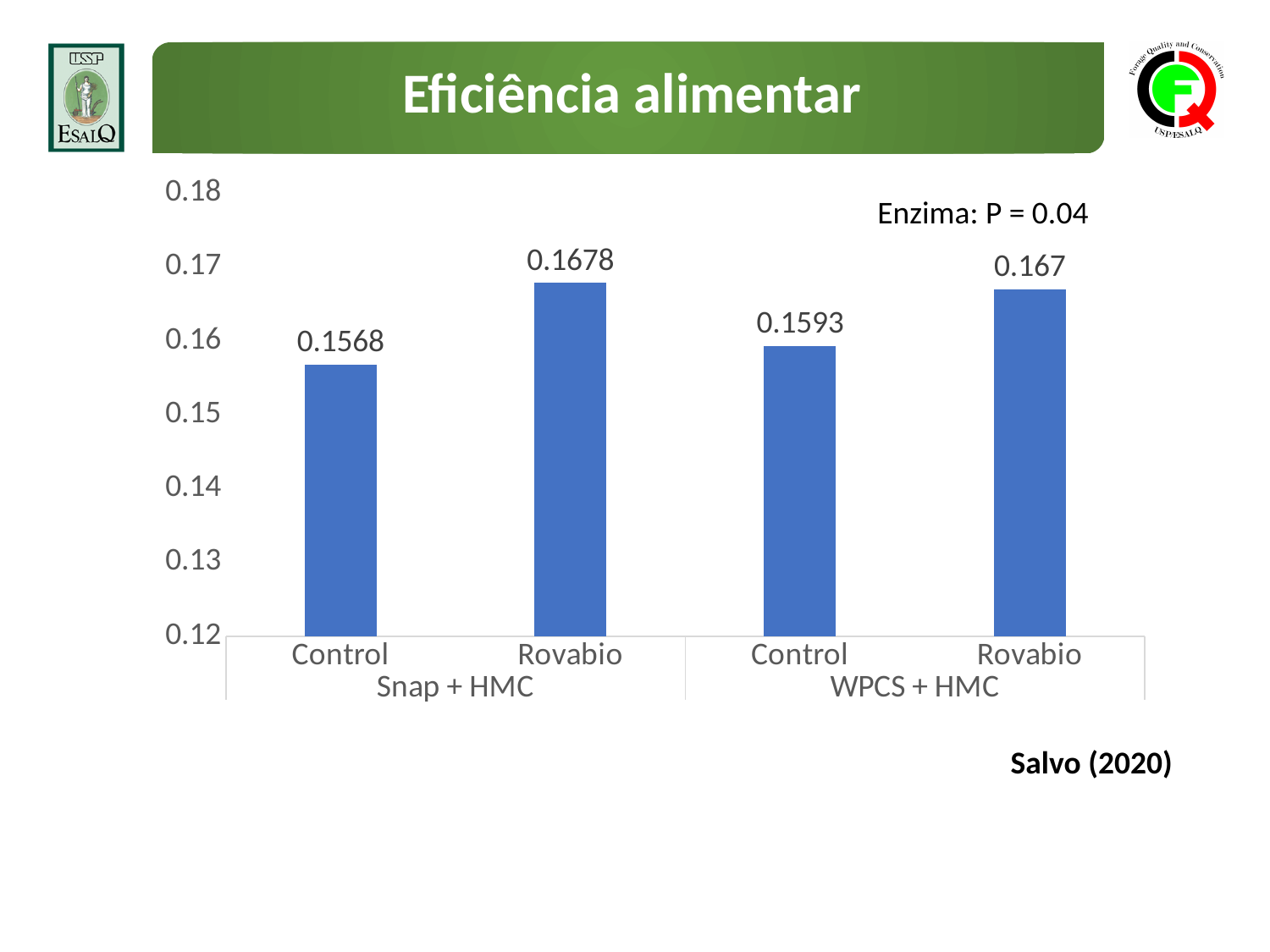
Which bar has the lowest value? Control (Snap + HMC) What is the value for Rovabio in the Snap + HMC group? 0.1678 What is the difference between Rovabio and Control in the WPCS + HMC group? 0.0077 What is the value for Rovabio in the WPCS + HMC group? 0.167 Which is larger: Control in Snap + HMC or Control in WPCS + HMC? Control in WPCS + HMC What is the value for Control in the WPCS + HMC group? 0.1593 What is the difference between Rovabio and Control in the Snap + HMC group? 0.011 What is the title of the chart? Eficiência alimentar What is the value for Control in the Snap + HMC group? 0.1568 How many bars are plotted in the chart? 4 Which bar has the highest value? Rovabio (Snap + HMC) What kind of chart is shown on the slide? Bar chart